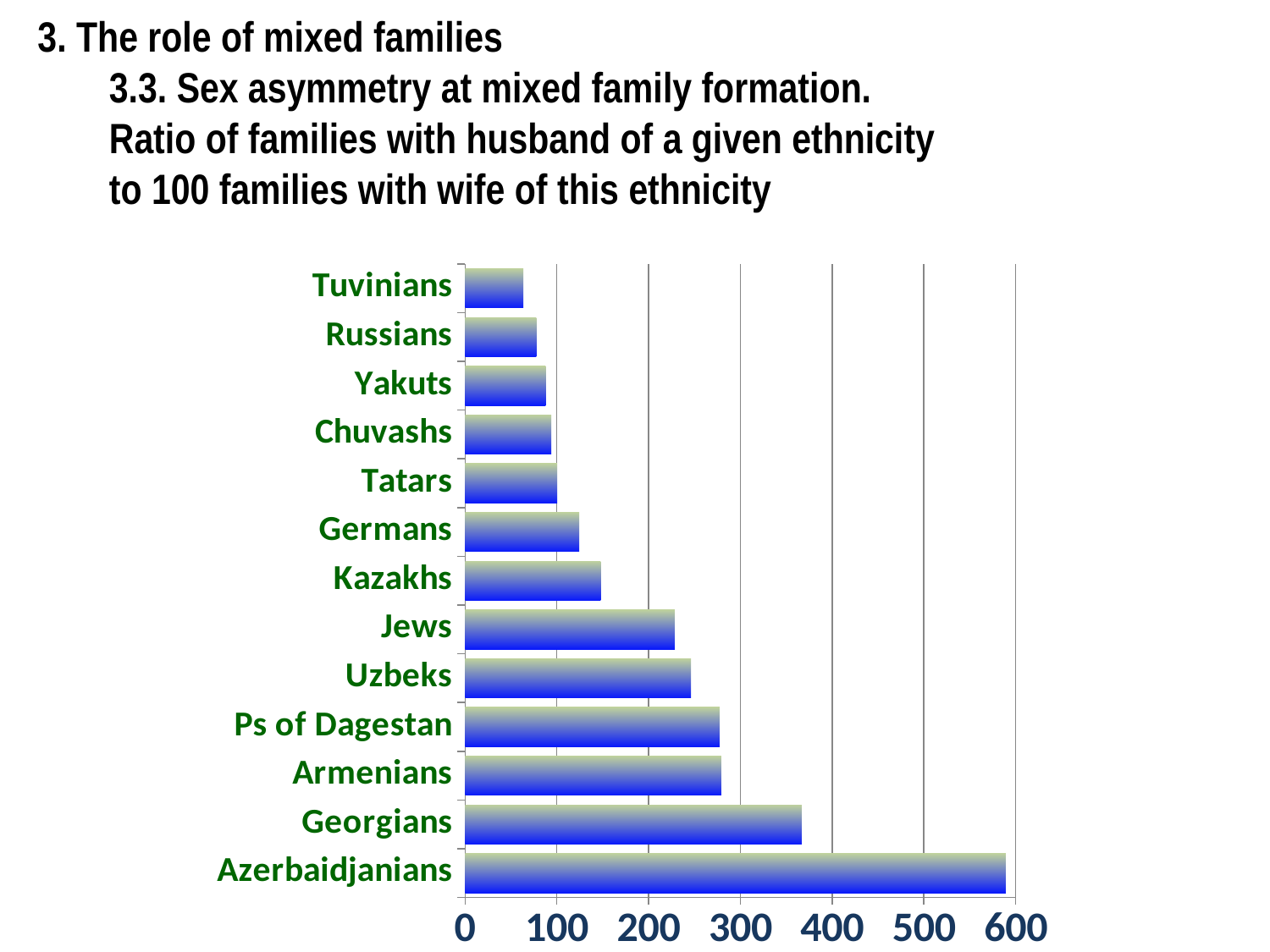
Which ethnic group has the highest ratio in the chart? Azerbaidjanians Is the value for Tuvinians greater or less than 100? less Which is larger, the value for Georgians or the value for Armenians? Georgians Which is larger, the value for Jews or the value for Kazakhs? Jews What kind of chart is shown on the slide? bar chart Is the value for Georgians greater or less than 300? greater What is the highest value shown on the horizontal axis of the chart? 600 Is the value for Jews greater or less than 200? greater Which ethnic group has the lowest ratio in the chart? Tuvinians How many ethnic groups are plotted in the chart? 13